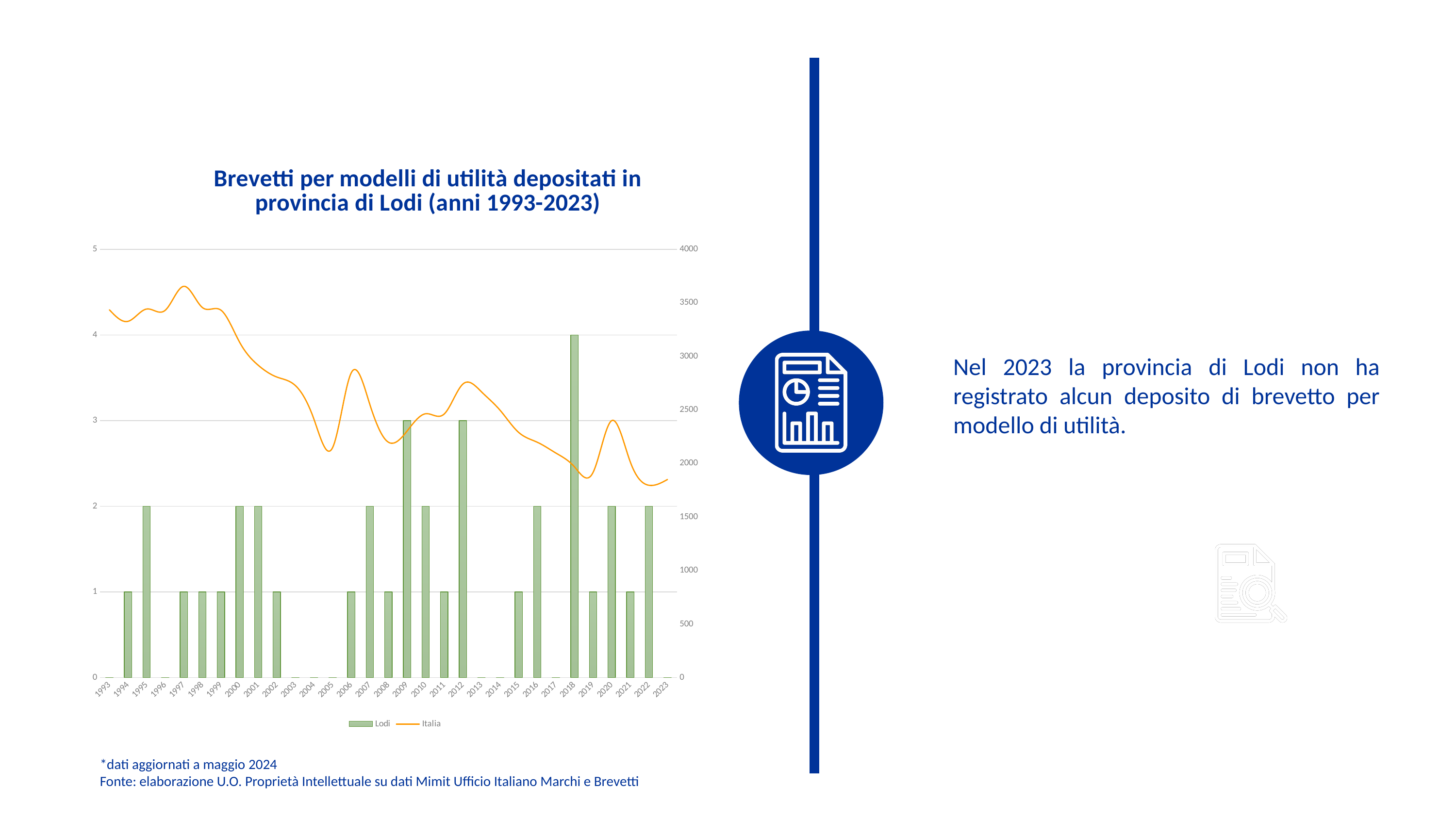
Is the value for Italia in 2023 greater or less than 2000? less What is the value for Lodi in 2009? 3 Is the value for Italia in 1997 greater or less than 3500? greater What is the value for Lodi in 2023? 0 What is the value for Lodi in 2018? 4 How many series does the legend list? 2 What kind of chart is this? Combined bar and line chart Which year has the highest value for Lodi? 2018 How many years are shown on the x axis? 31 Does the Italia line generally rise or fall from 1993 to 2023? Fall Which is larger, the Lodi value for 2000 or for 2002? 2000 What is the difference between the Lodi values for 2018 and 2012? 1